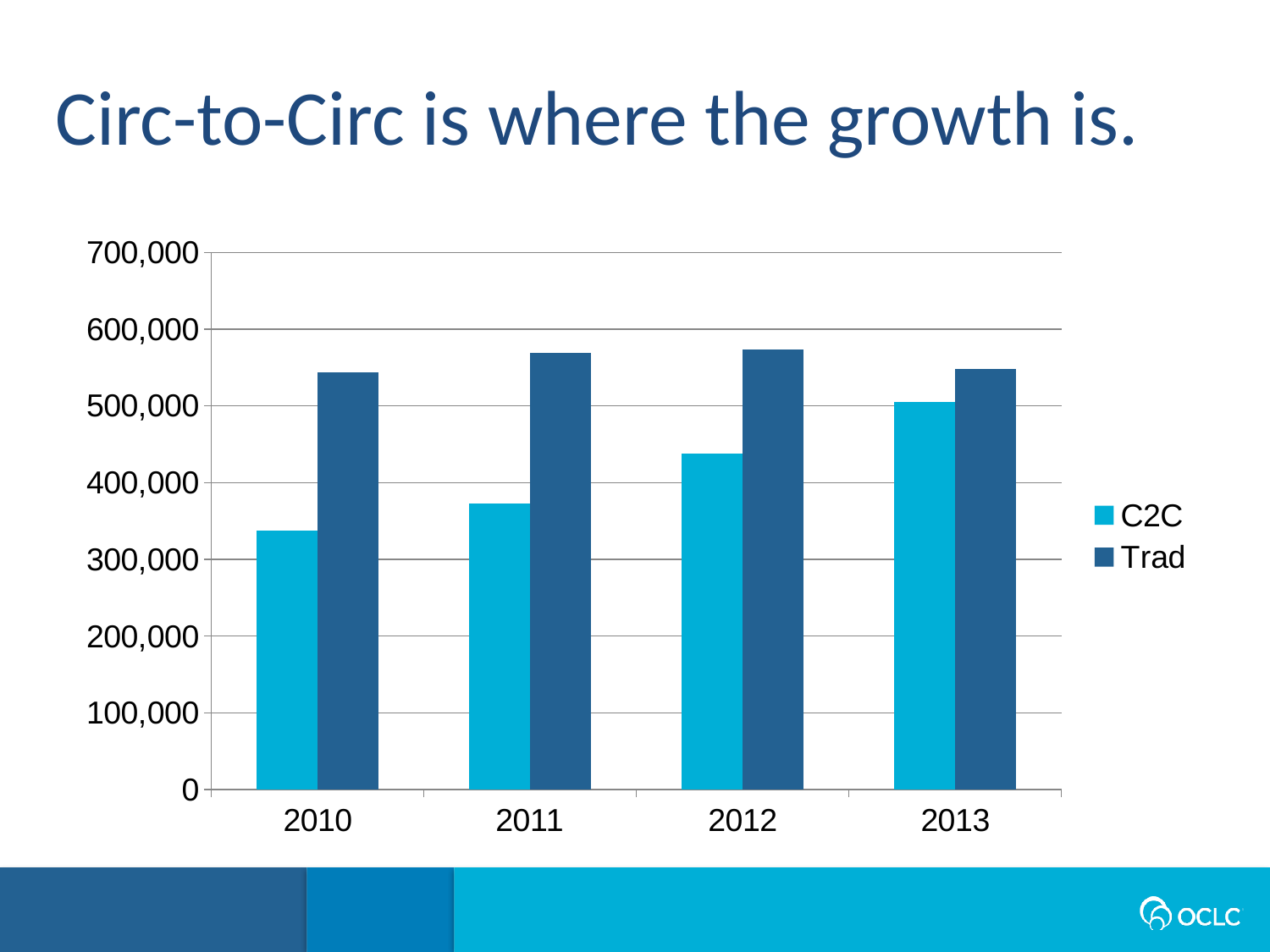
Do the C2C values rise or fall from 2010 to 2013? rise In which year is the C2C value lowest? 2010 What is the title of the slide? Circ-to-Circ is where the growth is. How many years are shown on the x axis? 4 Is the Trad value for 2011 greater or less than 600,000? less In which year is the C2C value highest? 2013 In 2010, which series has the larger value, C2C or Trad? Trad Is the C2C value for 2010 greater or less than 400,000? less Is the C2C value for 2012 greater or less than 400,000? greater How many series does the legend list? 2 What kind of chart is shown on the slide? bar chart